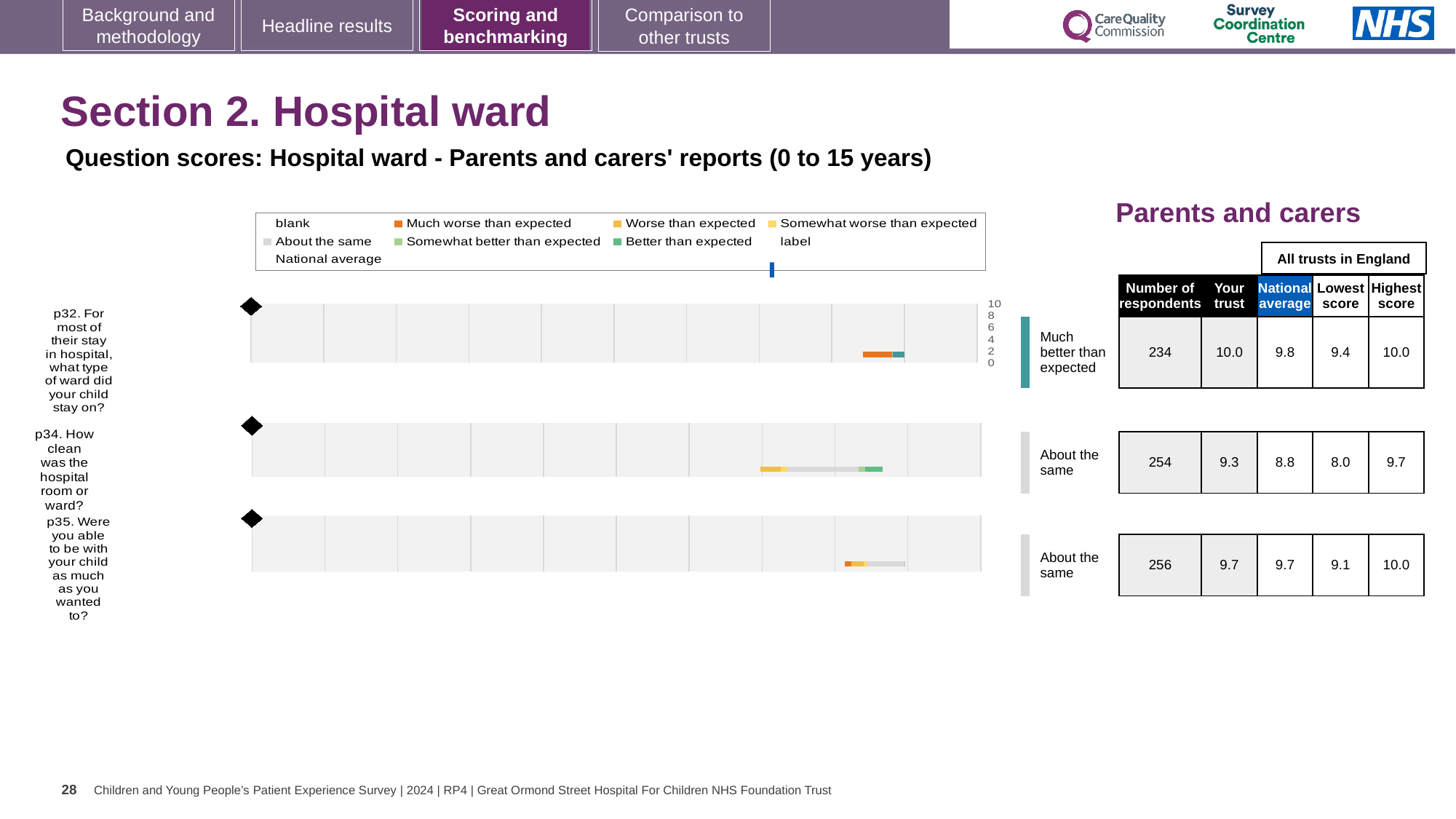
What is the national average score for p34 (how clean was the hospital room or ward)? 8.8 Which question has the highest number of respondents? p35. Were you able to be with your child as much as you wanted to? Which question has the lowest 'Your trust' score? p34. How clean was the hospital room or ward? What is the 'Your trust' score for p32 (what type of ward did your child stay on)? 10.0 How many questions (categories) are plotted in the chart? 3 For p32, which is larger: the 'Your trust' score or the national average? Your trust What is the lowest score among all trusts in England for p34? 8.0 In the chart legend, which colour represents 'Much worse than expected'? orange In the chart legend, which colour represents 'Better than expected'? teal What kind of chart is used to show the question scores on this slide? bar chart How many respondents answered p35 (were you able to be with your child as much as you wanted to)? 256 What is the difference between the 'Your trust' score and the national average for p34? 0.5